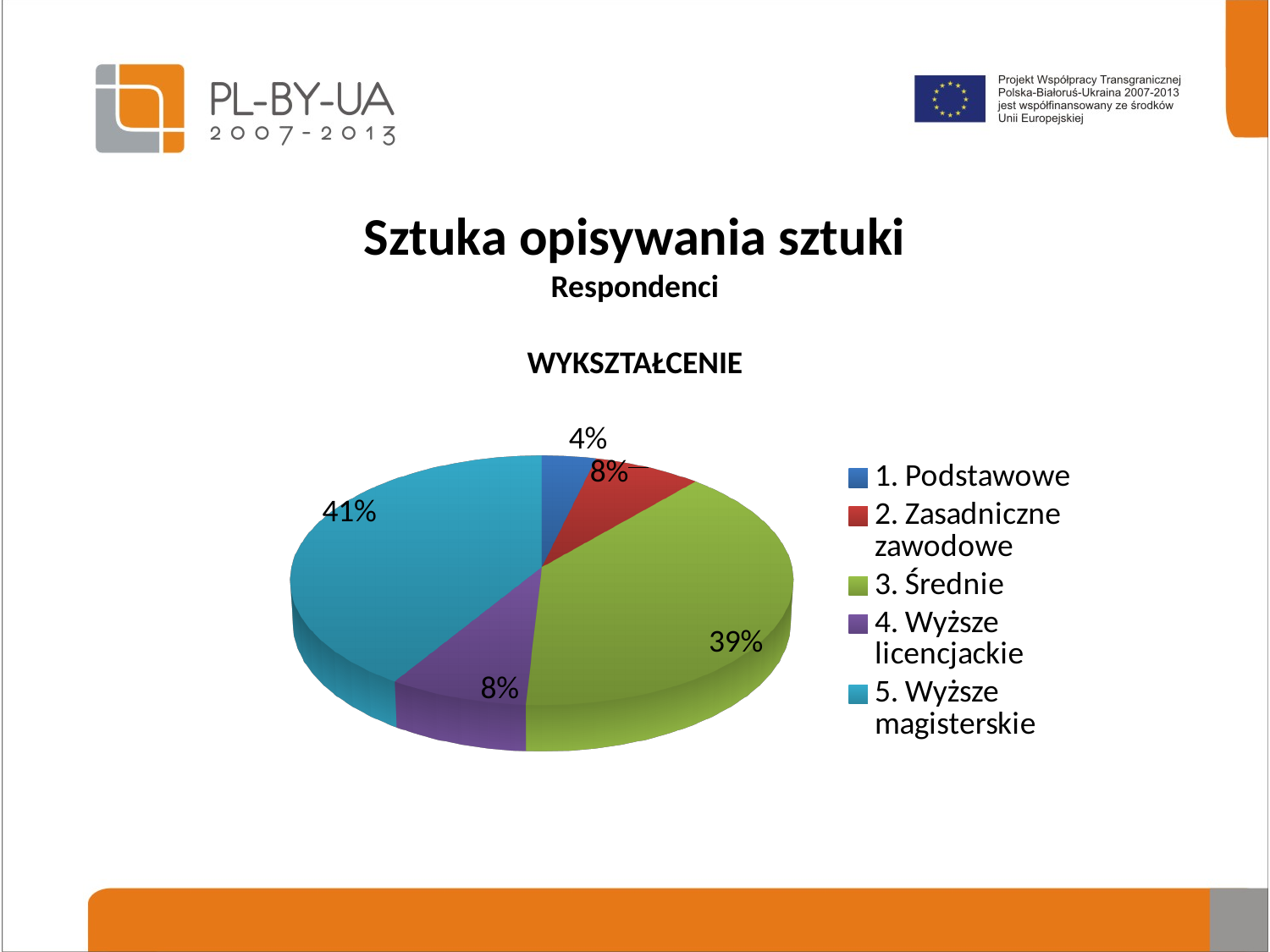
What share of the pie does "4. Wyższe licencjackie" have? 8% Which category has the smallest share of the pie? 1. Podstawowe What kind of chart is shown on the slide? pie chart What share of the pie does "2. Zasadnicze zawodowe" have? 8% What is the difference in percentage points between "5. Wyższe magisterskie" and "3. Średnie"? 2 percentage points What share of the pie does "5. Wyższe magisterskie" have? 41% How many categories does the legend of the chart list? 5 What is the title of the chart? WYKSZTAŁCENIE Which category has the largest share of the pie? 5. Wyższe magisterskie Which colour represents "3. Średnie" in the chart? green